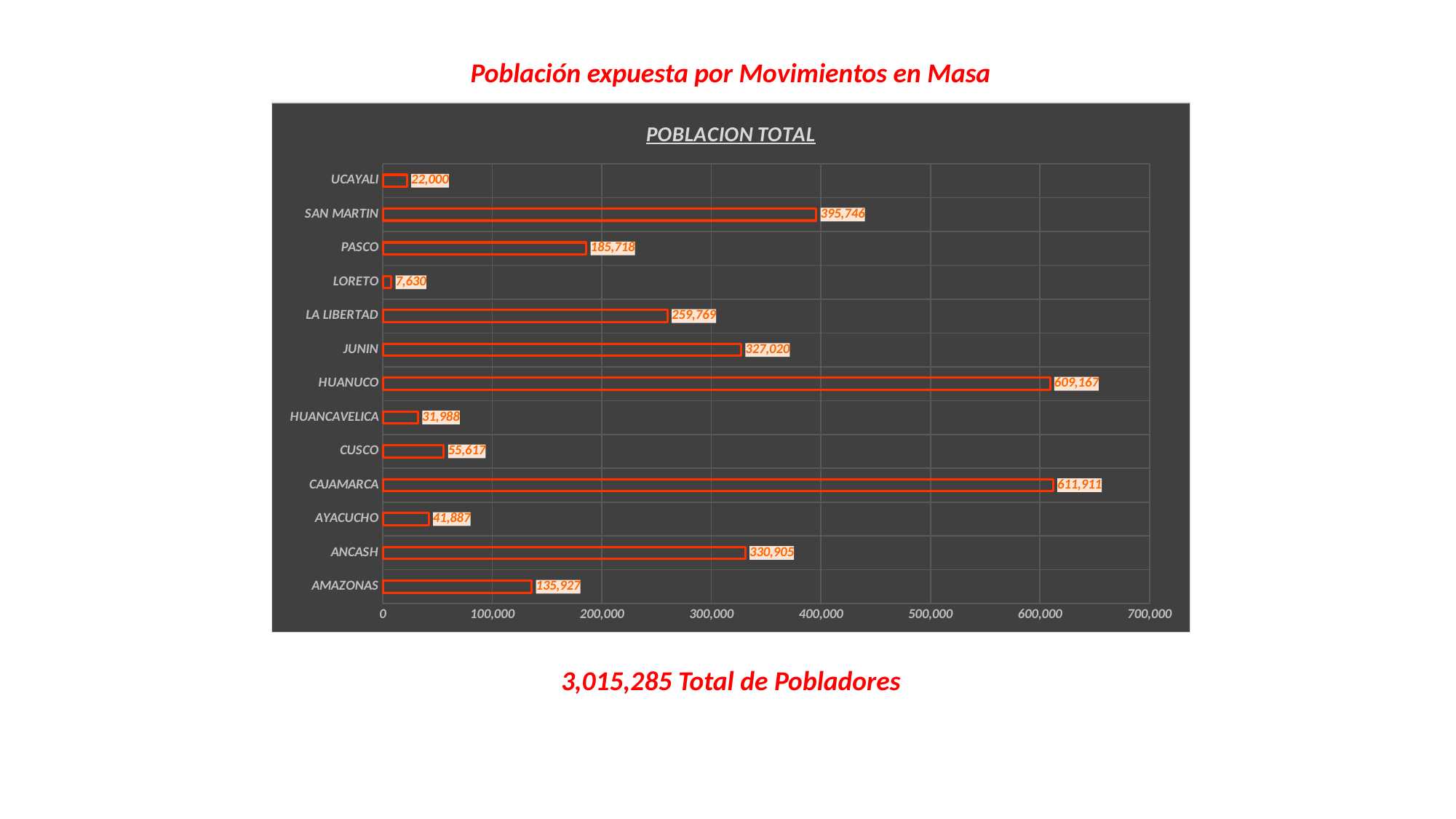
What is the title of the chart on the slide? POBLACION TOTAL How many categories are shown in the POBLACION TOTAL chart? 13 What is the value for HUANUCO in the POBLACION TOTAL chart? 609,167 What kind of chart is shown on the slide? bar chart What is the difference between the values for SAN MARTIN and JUNIN? 68,726 Which category has the highest value in the POBLACION TOTAL chart? CAJAMARCA Is the value for SAN MARTIN greater or less than 300,000? greater Which has a larger value, PASCO or LA LIBERTAD? LA LIBERTAD What is the difference between the values for CAJAMARCA and HUANUCO? 2,744 What is the value for AMAZONAS in the POBLACION TOTAL chart? 135,927 Which category has the lowest value in the POBLACION TOTAL chart? LORETO What is the value for LORETO in the POBLACION TOTAL chart? 7,630